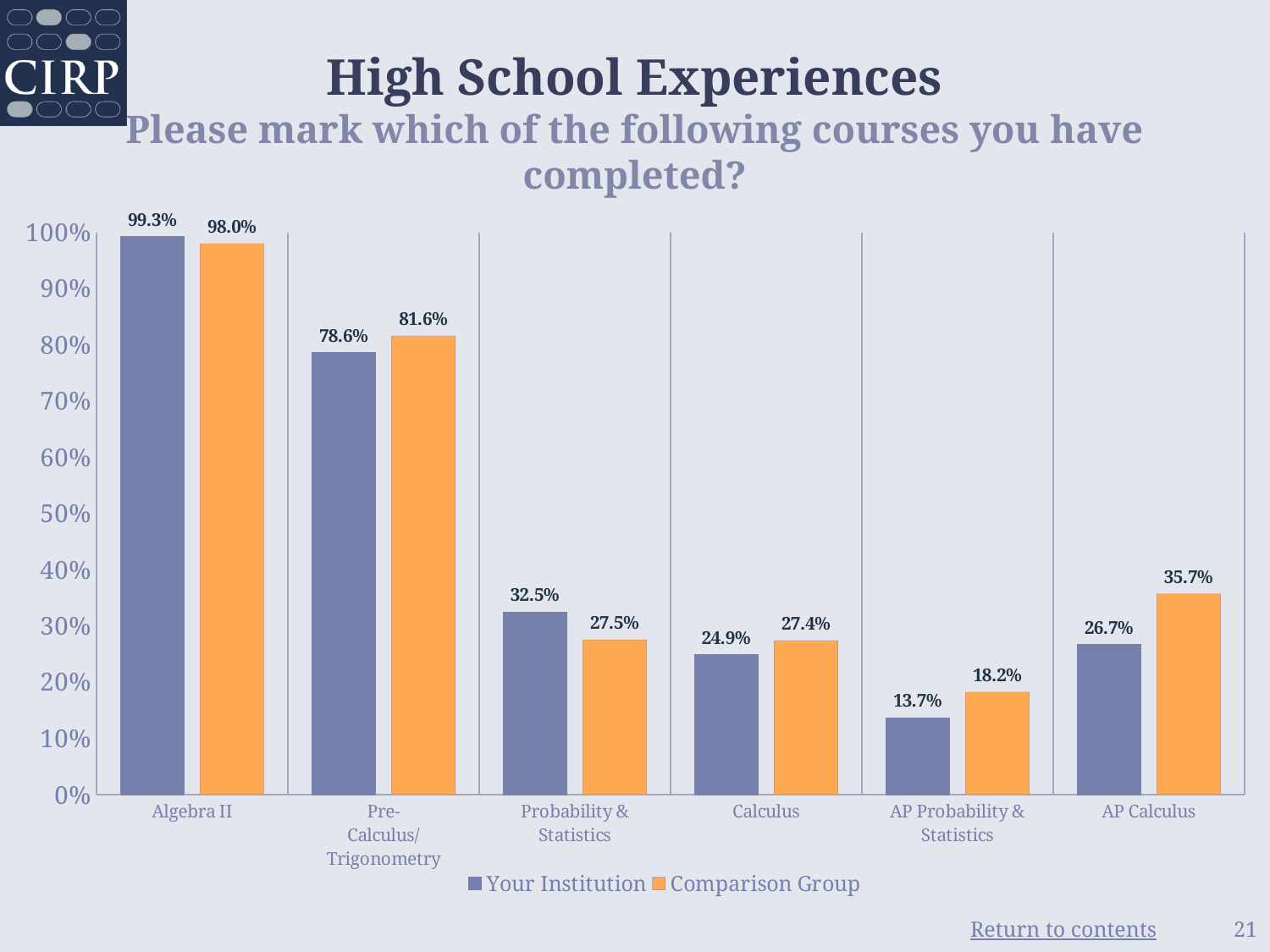
What is the Comparison Group value for AP Calculus? 35.7% For Probability & Statistics, which is larger: Your Institution or Comparison Group? Your Institution What is the Your Institution value for AP Probability & Statistics? 13.7% Which course has the highest Comparison Group value? Algebra II Which course has the lowest Your Institution value? AP Probability & Statistics Is the Your Institution value for Pre-Calculus/Trigonometry greater or less than 80%? less What colour are the Comparison Group bars? orange What percentage of Your Institution students completed Algebra II? 99.3% How many series does the legend list? 2 What is the difference between the Comparison Group and Your Institution values for AP Calculus? 9.0% How many courses are shown on the x axis? 6 What kind of chart is shown on the slide? bar chart